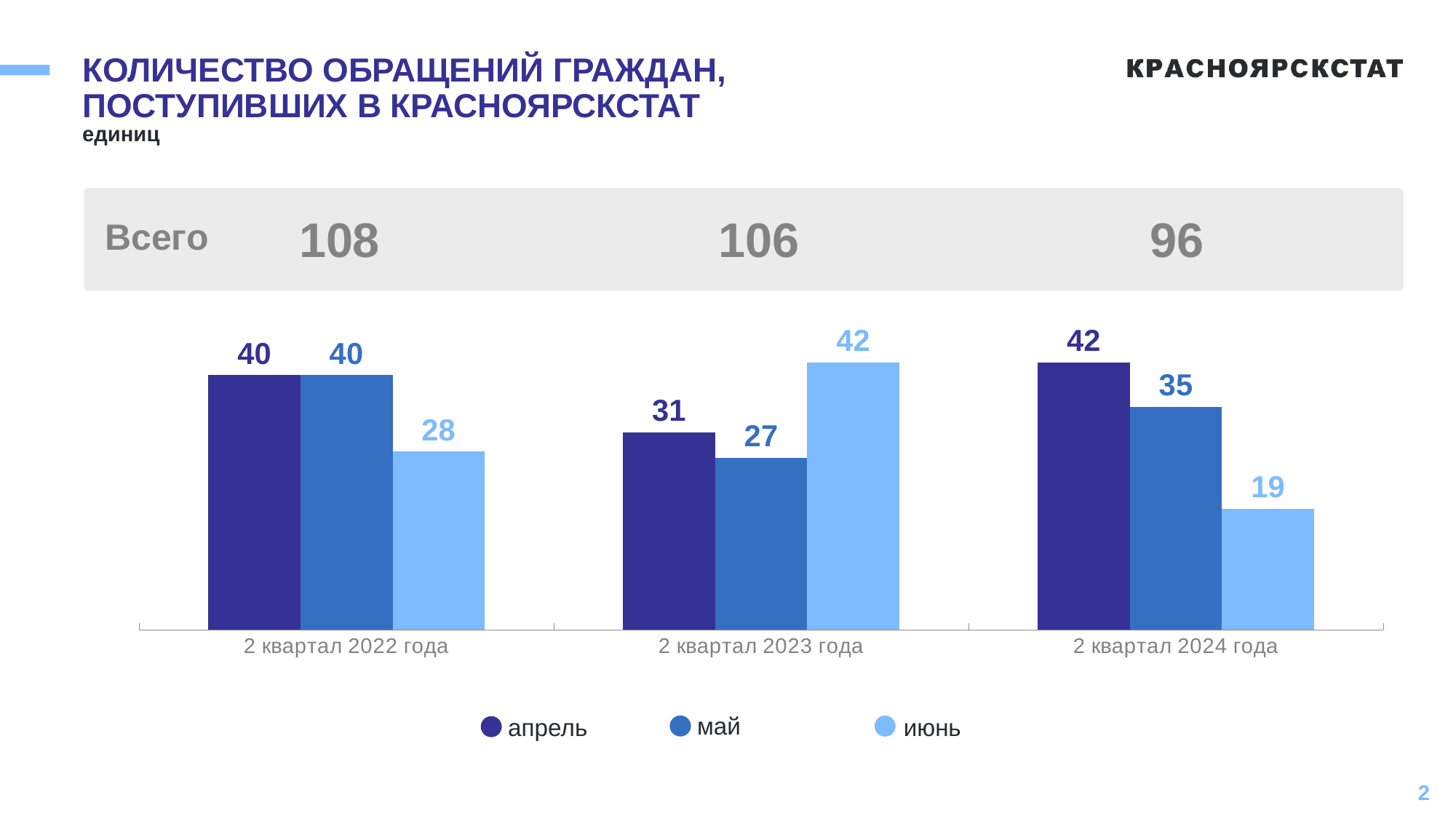
Which legend entry is shown in the lightest blue colour? июнь How many series does the legend list? 3 Which month has the lowest value in 2 квартал 2024 года? июнь What is the difference between the апрель and июнь values in 2 квартал 2024 года? 23 What kind of chart is shown on the slide? bar chart What is the value for июнь (June) in 2 квартал 2024 года? 19 How many quarter categories are shown on the x axis? 3 What is the value for апрель (April) in 2 квартал 2022 года? 40 Which is larger: the июнь value in 2 квартал 2022 года or the июнь value in 2 квартал 2023 года? 2 квартал 2023 года What is the total (Всего) shown for 2 квартал 2024 года? 96 Which month has the highest value in 2 квартал 2023 года? июнь What is the value for май (May) in 2 квартал 2023 года? 27